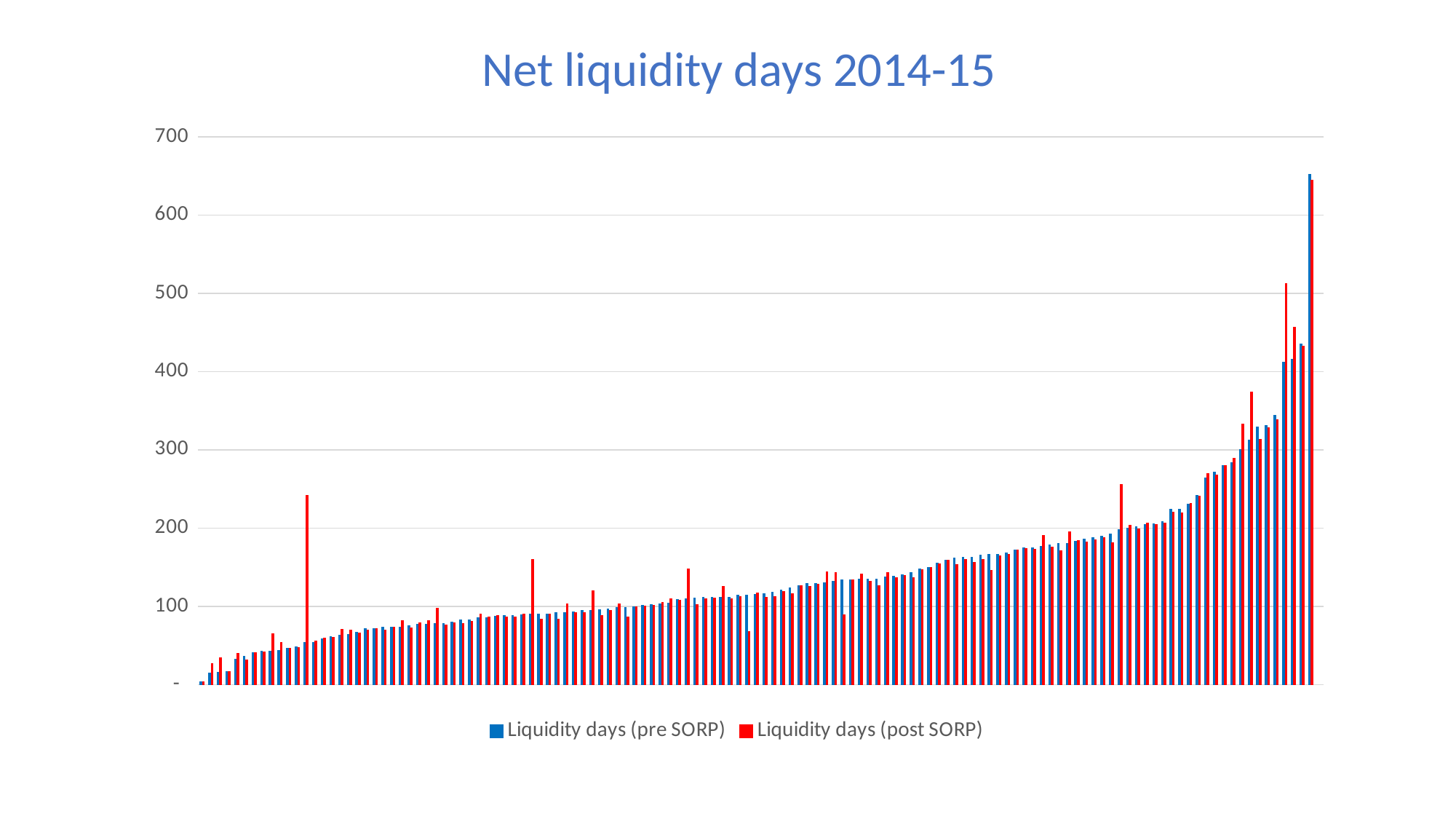
What is the title of the chart? Net liquidity days 2014-15 How many series does the legend list? 2 Is the leftmost bar on the chart greater or less than 100? less Is the tallest bar on the chart greater or less than 700? less Is the tallest red 'Liquidity days (post SORP)' bar greater or less than 500? greater Do the values generally rise or fall moving from left to right along the x axis? Rise Which colour represents the 'Liquidity days (post SORP)' series? Red What kind of chart is shown on the slide? Bar chart